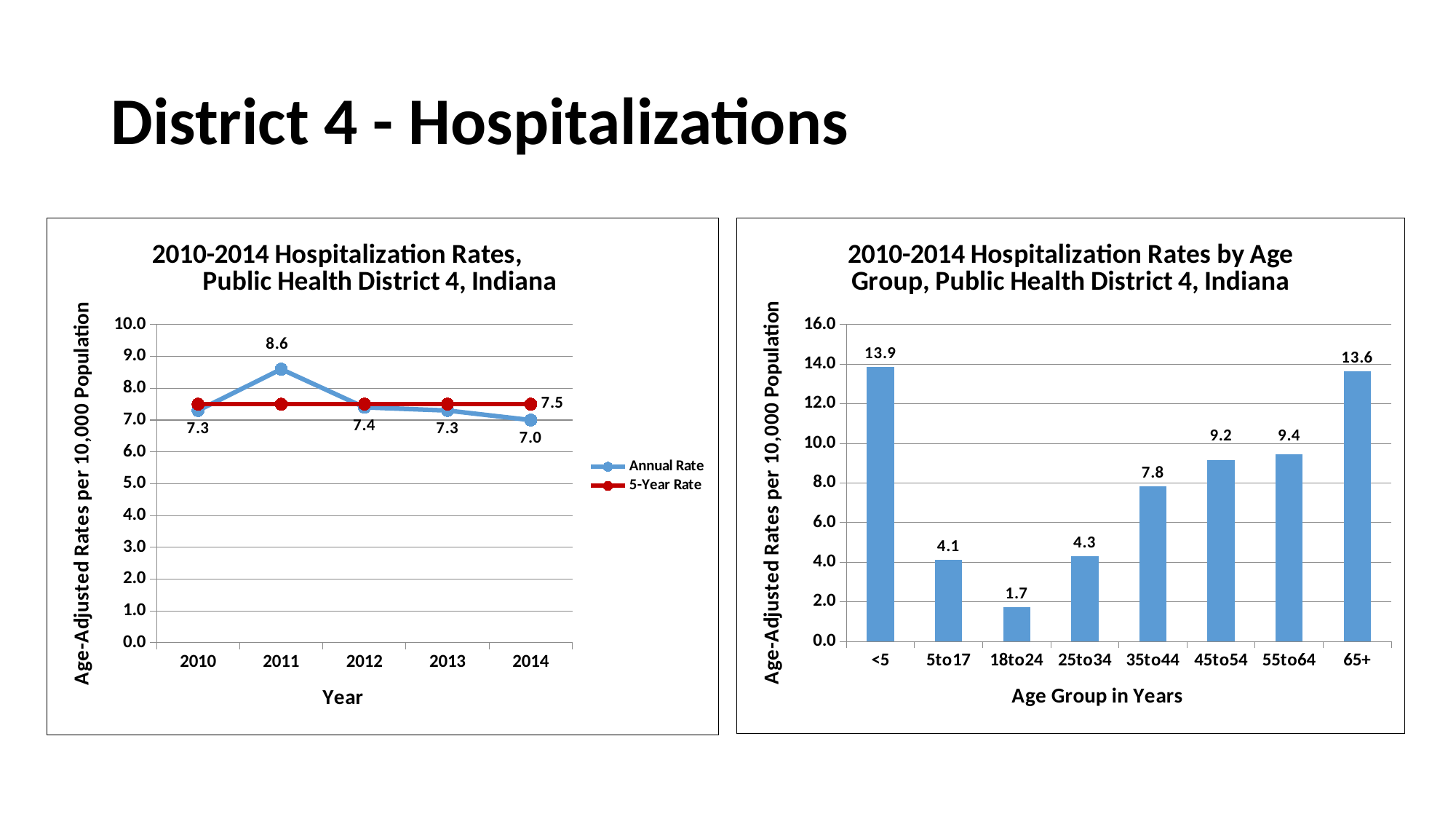
In the left chart (2010-2014 Hospitalization Rates, Public Health District 4, Indiana), what is the difference between the Annual Rate in 2011 and in 2014? 1.6 In the left chart (2010-2014 Hospitalization Rates, Public Health District 4, Indiana), which year has the lowest Annual Rate? 2014 In the right chart (2010-2014 Hospitalization Rates by Age Group), which is larger, the rate for 35to44 or for 45to54? 45to54 In the left chart (2010-2014 Hospitalization Rates, Public Health District 4, Indiana), what is the 5-Year Rate? 7.5 In the right chart (2010-2014 Hospitalization Rates by Age Group), which age group has the highest rate? <5 In the left chart (2010-2014 Hospitalization Rates, Public Health District 4, Indiana), does the Annual Rate rise or fall from 2011 to 2014? Fall In the right chart (2010-2014 Hospitalization Rates by Age Group), what is the difference between the rates for <5 and 65+? 0.3 In the left chart (2010-2014 Hospitalization Rates, Public Health District 4, Indiana), how many series does the legend list? 2 In the left chart (2010-2014 Hospitalization Rates, Public Health District 4, Indiana), what kind of chart is shown? Line chart In the left chart (2010-2014 Hospitalization Rates, Public Health District 4, Indiana), what is the Annual Rate for 2011? 8.6 In the right chart (2010-2014 Hospitalization Rates by Age Group), what is the rate for the 18to24 age group? 1.7 In the right chart (2010-2014 Hospitalization Rates by Age Group), how many age groups are shown? 8